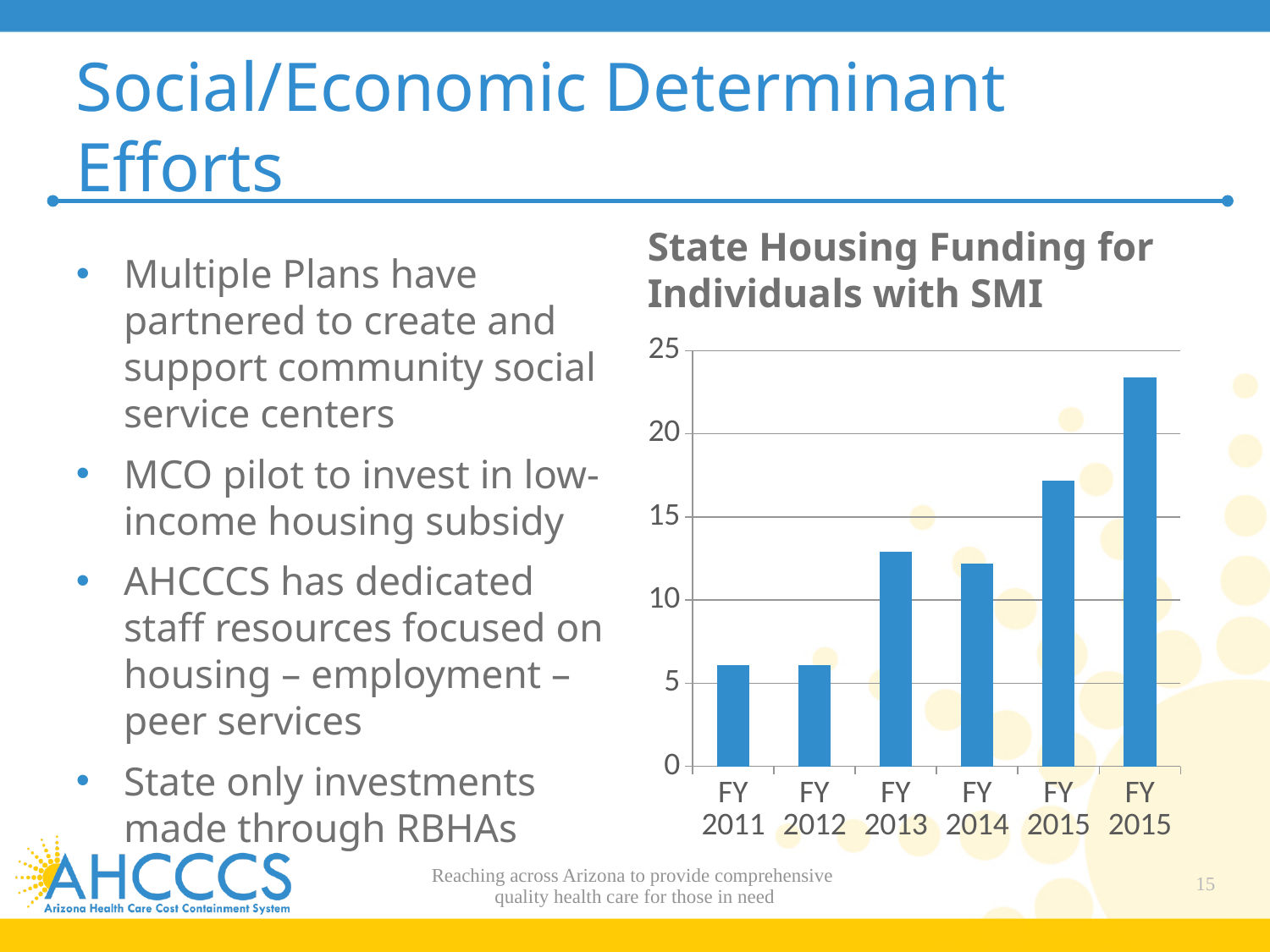
Is the value for FY 2011 greater or less than 5? greater What kind of chart is shown on the slide? bar chart Do the values in the State Housing Funding chart generally rise or fall from left to right? rise What is the highest value shown on the vertical axis of the chart? 25 Is the value of the fifth bar (the first one labeled FY 2015) greater or less than 15? greater Is the value for FY 2013 greater or less than 15? less How many bars are plotted in the State Housing Funding chart? 6 Which bar in the State Housing Funding chart is the highest? the rightmost bar (the second one labeled FY 2015) What is the title of the chart on the slide? State Housing Funding for Individuals with SMI Which is larger, the value for FY 2011 or the value for FY 2013? FY 2013